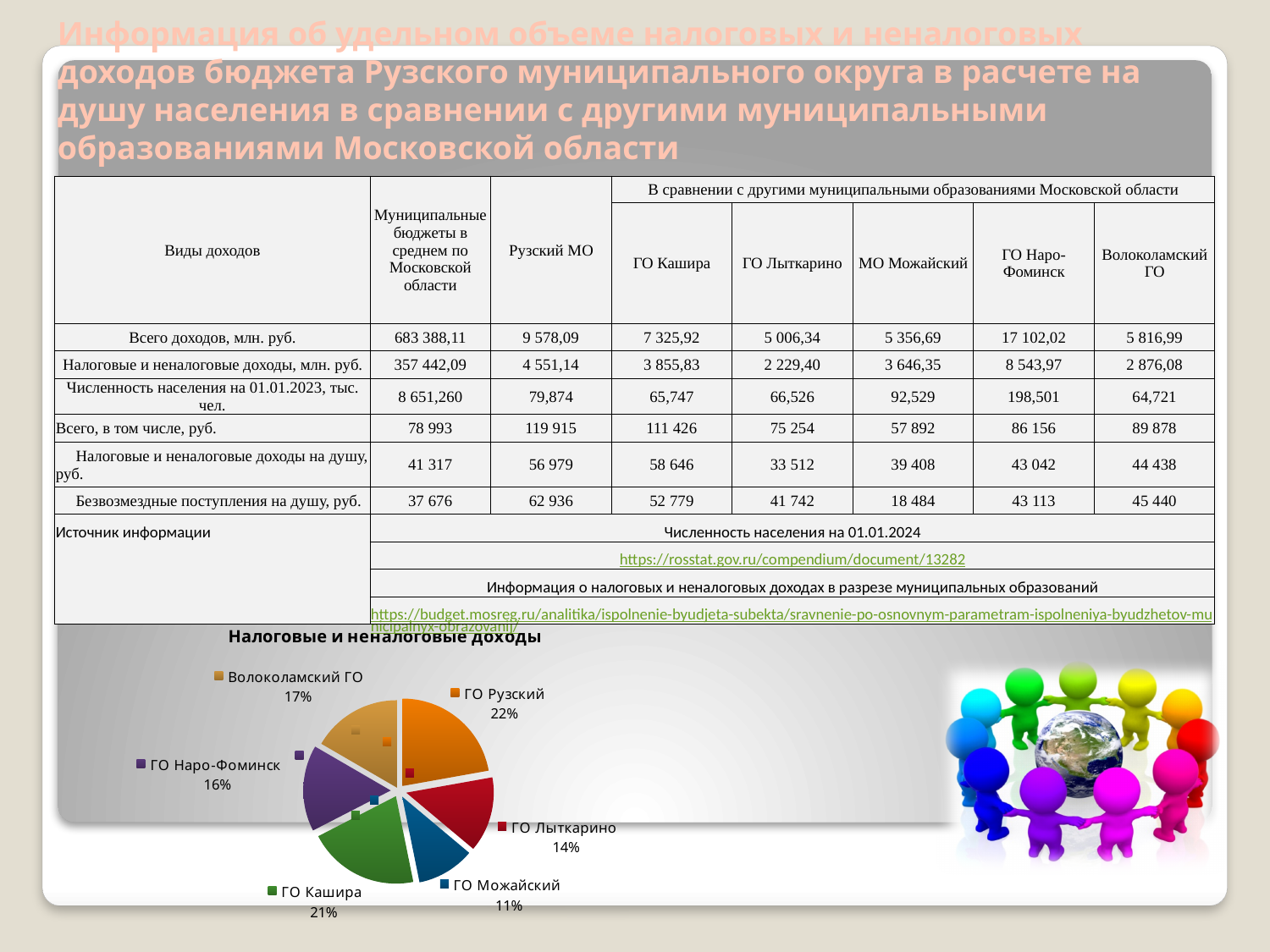
How many slices does the pie chart have? 6 In the pie chart, which has a larger share: Волоколамский ГО or ГО Наро-Фоминск? Волоколамский ГО In the pie chart, what is the difference between the shares of ГО Рузский and ГО Можайский? 11% What share of the pie chart does ГО Рузский have? 22% Which slice of the pie chart is the smallest? ГО Можайский What is the title of the pie chart? Налоговые и неналоговые доходы What share of the pie chart does ГО Лыткарино have? 14% In the pie chart, what is the difference between the shares of ГО Кашира and ГО Лыткарино? 7% What share of the pie chart does ГО Наро-Фоминск have? 16% Which slice of the pie chart is the largest? ГО Рузский What kind of chart is shown at the bottom of the slide? Pie chart